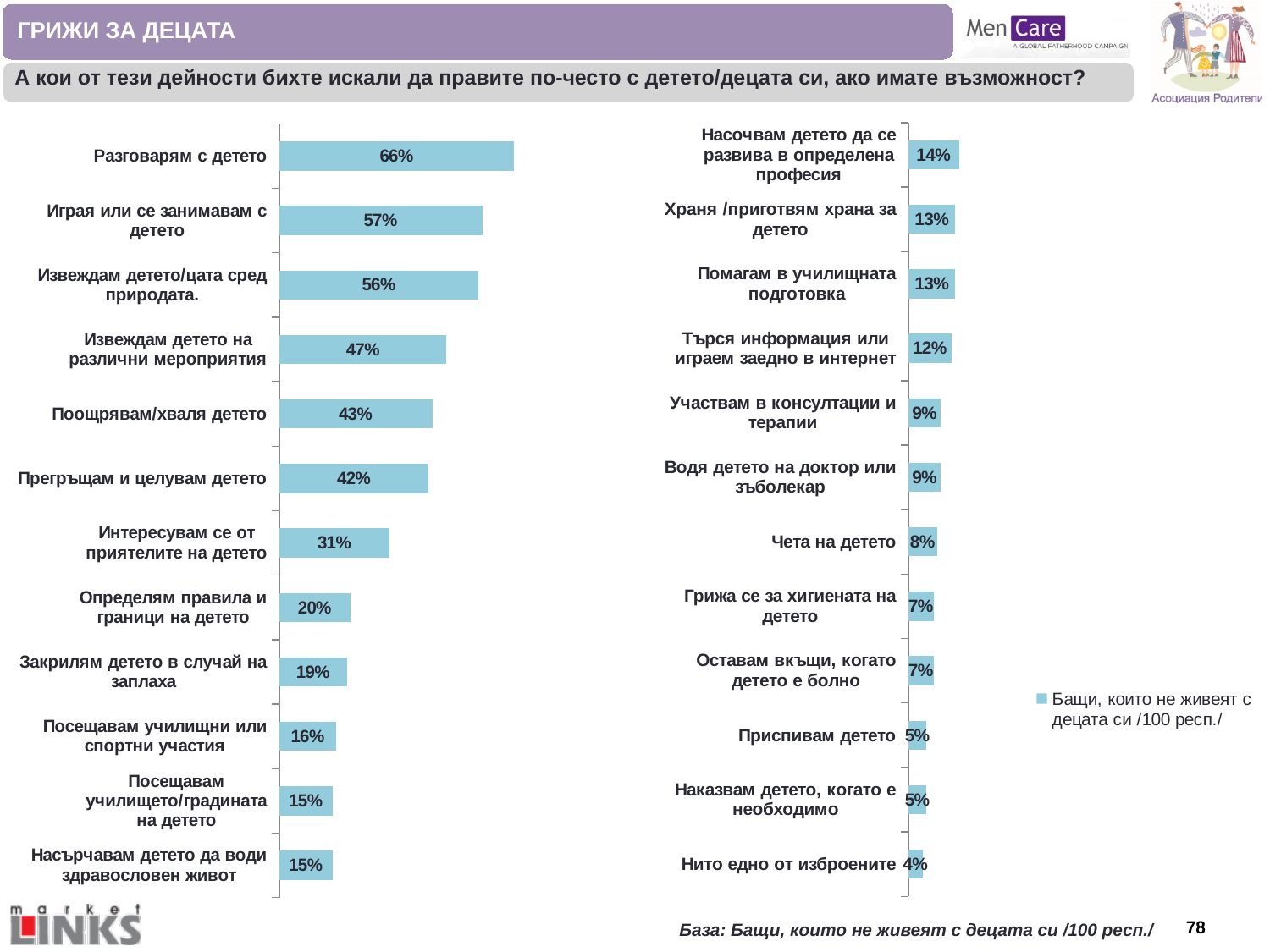
What type of chart is the left chart? Bar chart On the right chart, what is the value for "Чета на детето"? 8% On the right chart, which is larger: "Насочвам детето да се развива в определена професия" or "Търся информация или играем заедно в интернет"? Насочвам детето да се развива в определена професия On the left chart, what is the difference between "Играя или се занимавам с детето" and "Интересувам се от приятелите на детето"? 26% How many categories are shown on the left chart? 12 How many categories are shown on the right chart? 12 What series does the legend on the slide list? Бащи, които не живеят с децата си /100 респ./ On the left chart, which category has the highest value? Разговарям с детето On the right chart, which category has the lowest value? Нито едно от изброените On the right chart, what is the difference between "Храня /приготвям храна за детето" and "Приспивам детето"? 8% On the left chart, what is the value for "Разговарям с детето"? 66% On the left chart, what is the value for "Поощрявам/хваля детето"? 43%